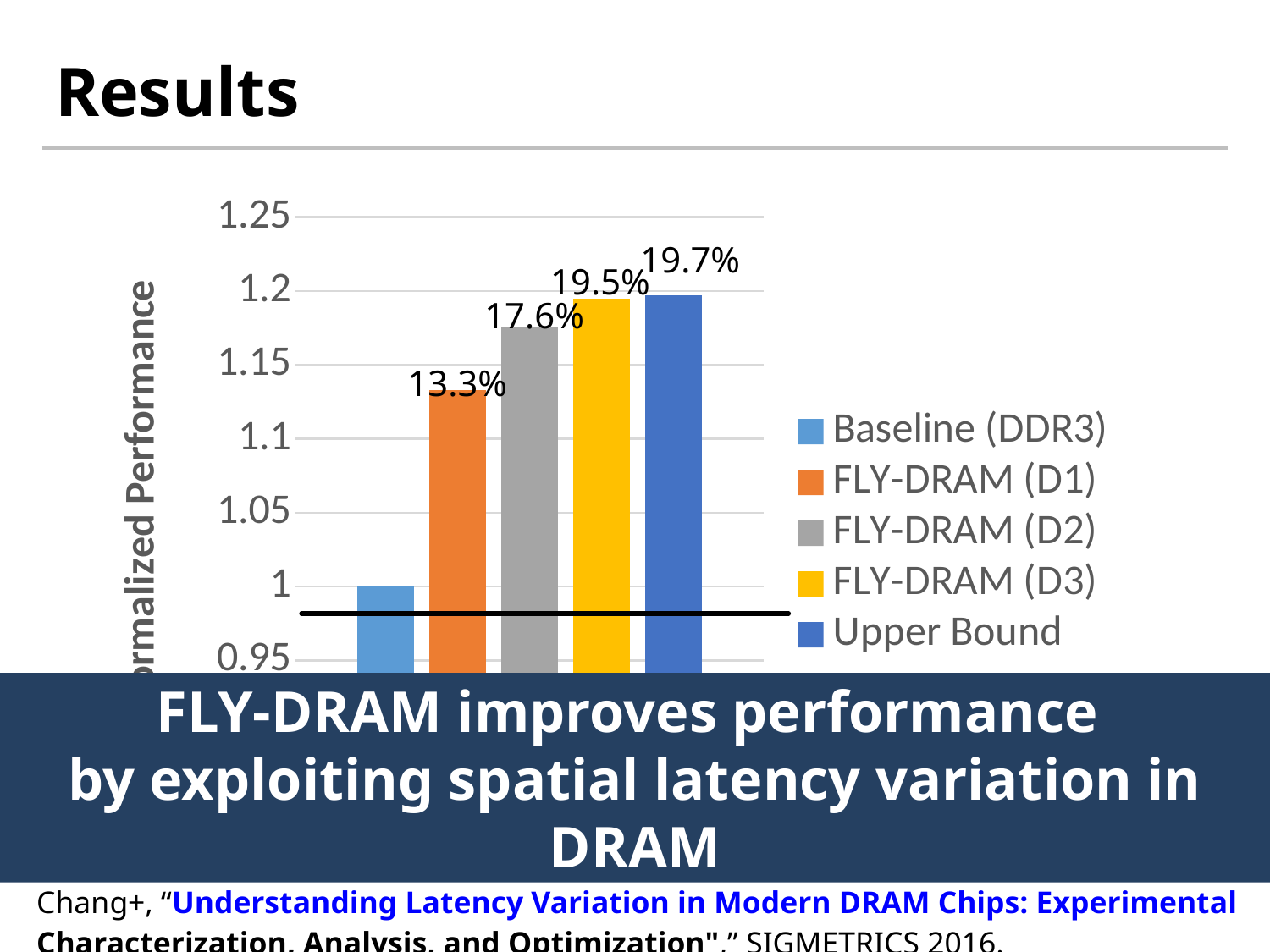
Which is larger, the normalized performance for FLY-DRAM (D2) or FLY-DRAM (D1)? FLY-DRAM (D2) What is the data label shown above the FLY-DRAM (D3) bar? 19.5% Is the normalized performance for FLY-DRAM (D1) greater or less than 1.1? greater What is the data label shown above the Upper Bound bar? 19.7% How many series does the legend list? 5 What is the data label shown above the FLY-DRAM (D1) bar? 13.3% What kind of chart is shown on the slide? bar chart Which series has the highest normalized performance? Upper Bound What is the data label shown above the FLY-DRAM (D2) bar? 17.6% What normalized performance value does the Baseline (DDR3) bar reach? 1 Do the bar values rise or fall from left to right across the chart? rise Which series has the lowest normalized performance? Baseline (DDR3)